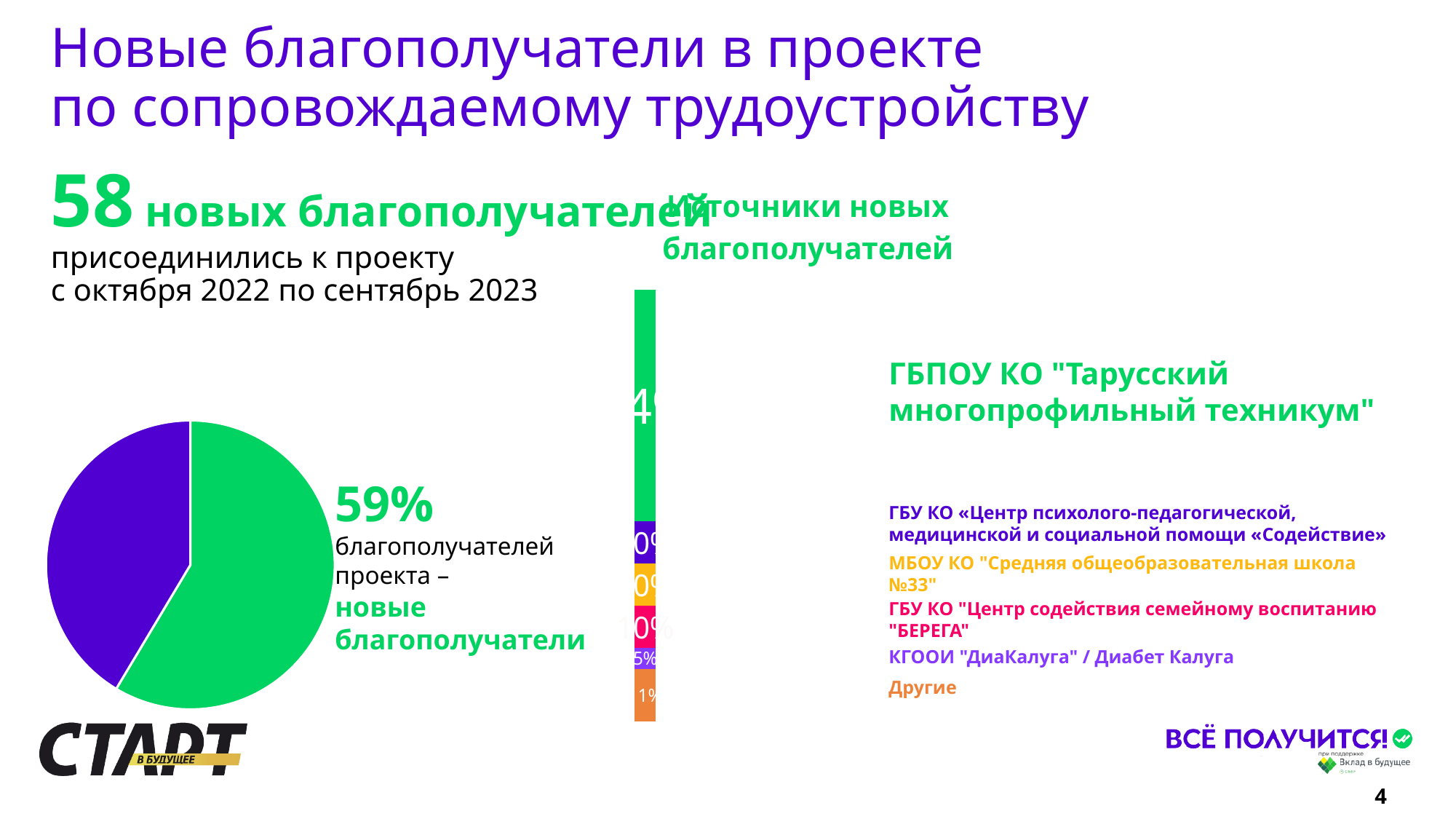
On the "Источники новых благополучателей" chart, what is the value for КГООИ "ДиаКалуга" / Диабет Калуга? 5% On the "Источники новых благополучателей" chart, what is the difference between the value for "БЕРЕГА" and the value for КГООИ "ДиаКалуга"? 5% How many sources are listed in the legend of the "Источники новых благополучателей" chart? 6 On the "Источники новых благополучателей" chart, what is the value for ГБУ КО "Центр содействия семейному воспитанию "БЕРЕГА""? 10% On the "Источники новых благополучателей" chart, which source has the largest segment? ГБПОУ КО "Тарусский многопрофильный техникум" How many slices does the pie chart have? 2 What kind of chart is the chart on the left of the slide? pie chart On the "Источники новых благополучателей" chart, which is larger: the value for "БЕРЕГА" or the value for КГООИ "ДиаКалуга"? "БЕРЕГА" What kind of chart is the chart titled "Источники новых благополучателей"? bar chart On the pie chart, what share of the project's beneficiaries are new beneficiaries? 59% On the "Источники новых благополучателей" chart, which source has the smallest segment? КГООИ "ДиаКалуга" / Диабет Калуга